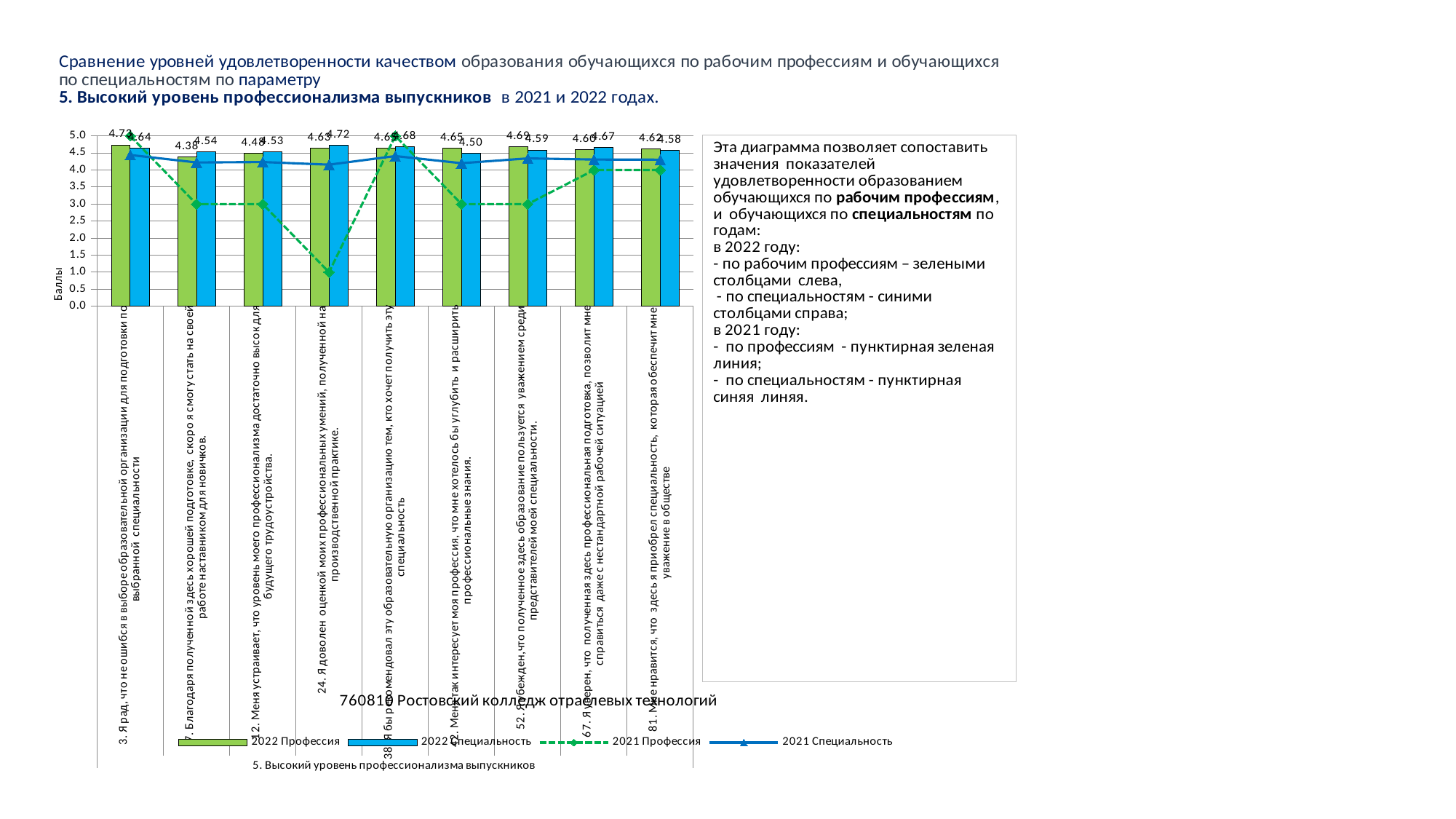
Which statement has the highest 2022 Специальность value? 24. Я доволен оценкой моих профессиональных умений, полученной на производственной практике (4.72) Which series is drawn as a dashed green line? 2021 Профессия For statement 24, which is larger in 2022: Профессия or Специальность? Специальность Is the 2021 Профессия value for statement 24 greater or less than 2.0? less What is the difference between the 2022 Специальность and 2022 Профессия values for statement 7? 0.16 How many series does the legend list? 4 How many categories (statements) are plotted along the x axis? 9 What is the label of the vertical axis? Баллы What kind of chart is shown on the slide? A combined bar and line chart Which statement has the lowest 2022 Профессия value? 7. Благодаря полученной здесь хорошей подготовке, скоро я смогу стать на своей работе наставником для новичков (4.38) What is the 2022 Профессия value for statement 3 (Я рад, что не ошибся в выборе образовательной организации)? 4.73 What is the 2022 Специальность value for statement 7 (Благодаря полученной здесь хорошей подготовке...)? 4.54